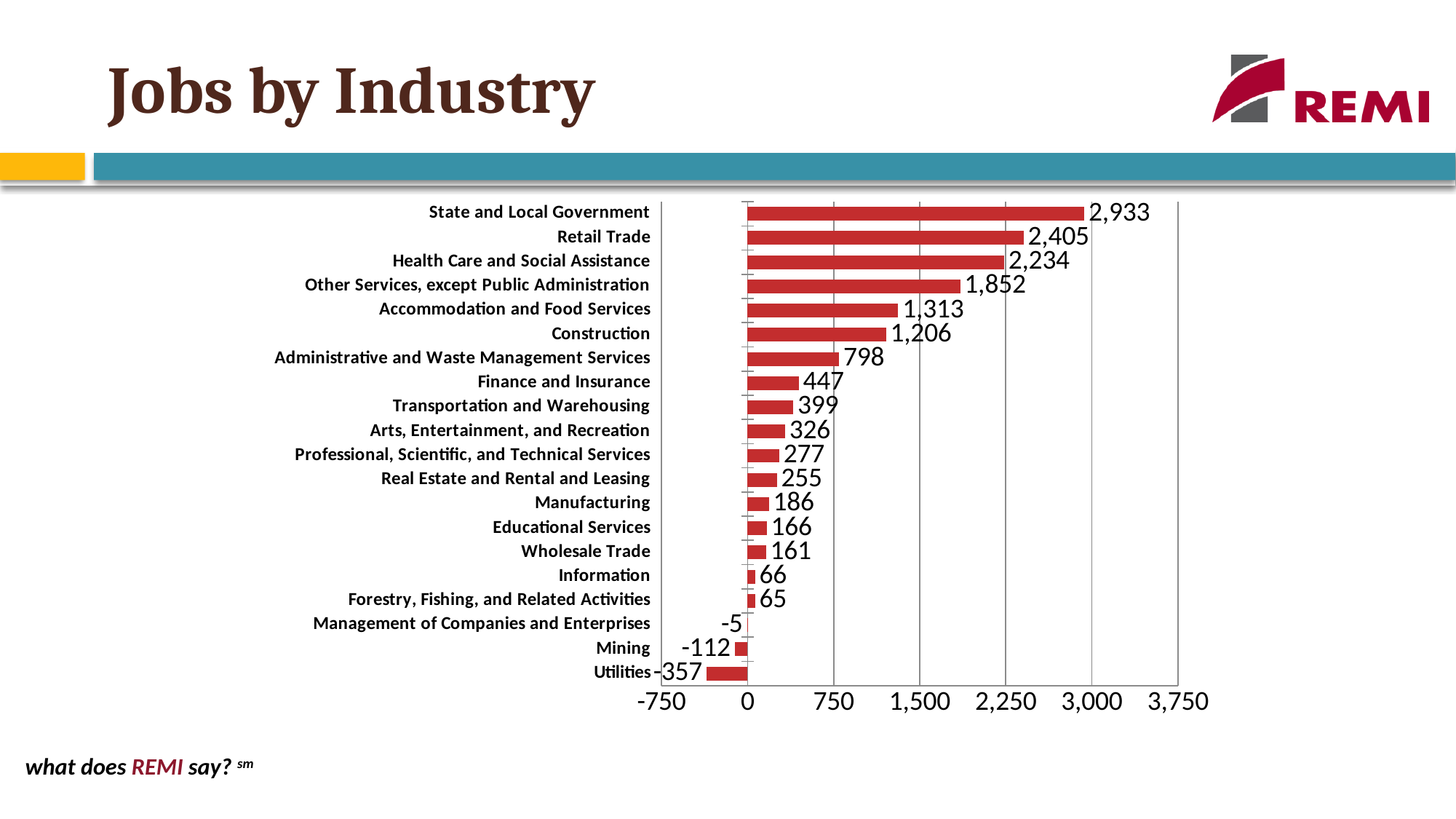
What is the value for Retail Trade? 2,405 What is the value for Mining? -112 Which industry has the highest value? State and Local Government What is the value for Utilities? -357 What is the title of the slide? Jobs by Industry Which is larger, Finance and Insurance or Transportation and Warehousing? Finance and Insurance What is the value for Construction? 1,206 What kind of chart is shown on the slide? Bar chart What is the difference between Accommodation and Food Services and Construction? 107 How many industries are shown in the chart? 20 Which industry has the lowest value? Utilities What is the difference between State and Local Government and Retail Trade? 528